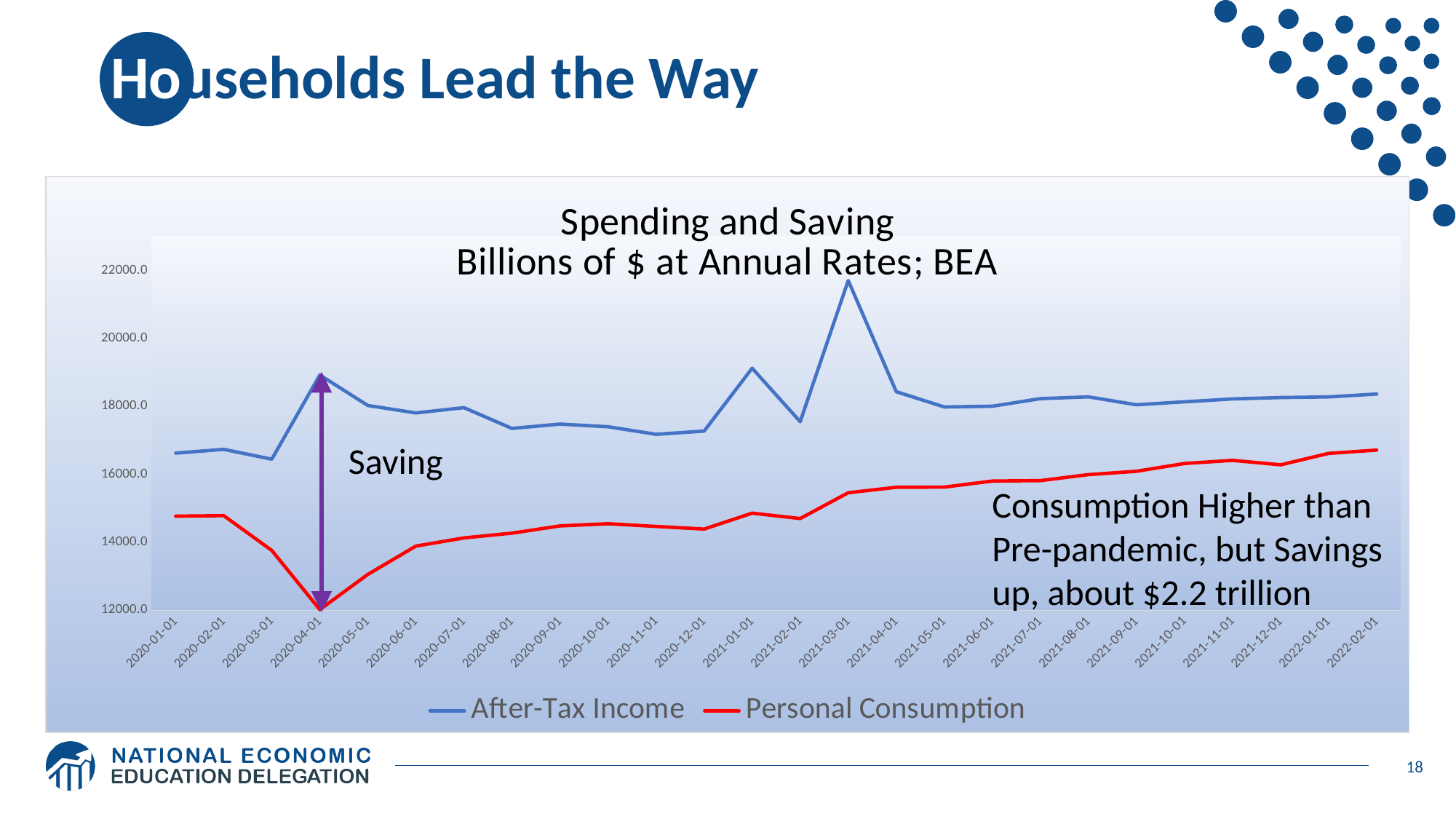
Is the value for After-Tax Income at 2021-03-01 greater or less than 20000.0? greater What is the title of the chart? Spending and Saving Billions of $ at Annual Rates; BEA How many dates are shown along the x axis of the chart? 26 Is the value for After-Tax Income at 2020-01-01 greater or less than 18000.0? less Which is larger at 2021-03-01, After-Tax Income or Personal Consumption? After-Tax Income Is the value for Personal Consumption at 2022-02-01 greater or less than 16000.0? greater Does Personal Consumption generally rise or fall from 2020-04-01 to 2022-02-01? Rise At which date does After-Tax Income reach its highest value? 2021-03-01 How many series does the chart legend list? 2 What kind of chart is shown on the slide? Line chart At which date does Personal Consumption reach its lowest value? 2020-04-01